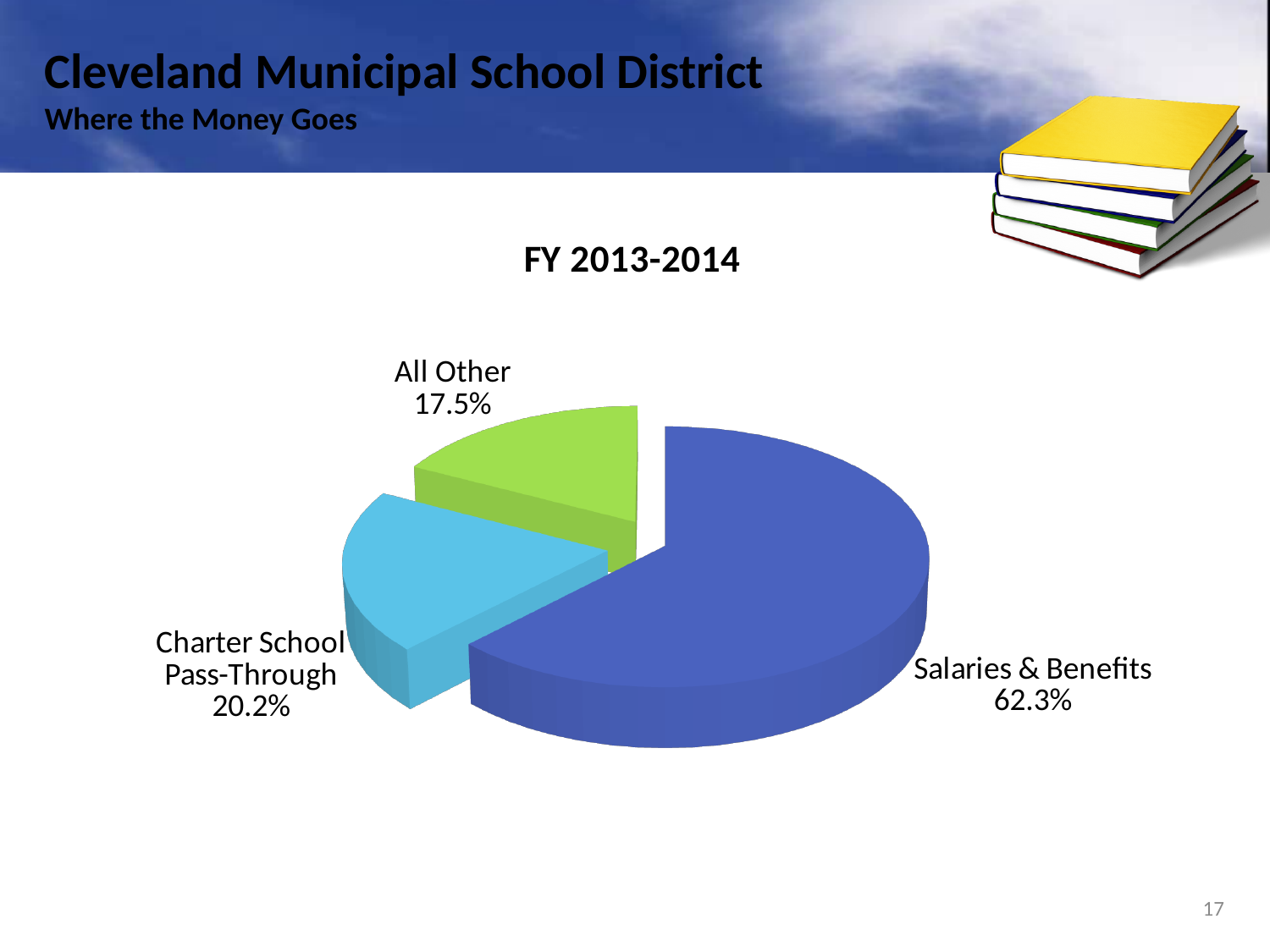
What kind of chart is shown on the slide? Pie chart What share of the pie does Charter School Pass-Through represent? 20.2% Which category has the largest slice of the pie? Salaries & Benefits What is the title of the chart? FY 2013-2014 What is the difference in percentage points between Salaries & Benefits and Charter School Pass-Through? 42.1 What colour is the Salaries & Benefits slice? Blue What share of the pie does Salaries & Benefits represent? 62.3% How many categories are shown in the pie chart? 3 What share of the pie does All Other represent? 17.5% Which category has the smallest slice of the pie? All Other Which is larger, the share for Charter School Pass-Through or the share for All Other? Charter School Pass-Through What is the difference in percentage points between Charter School Pass-Through and All Other? 2.7